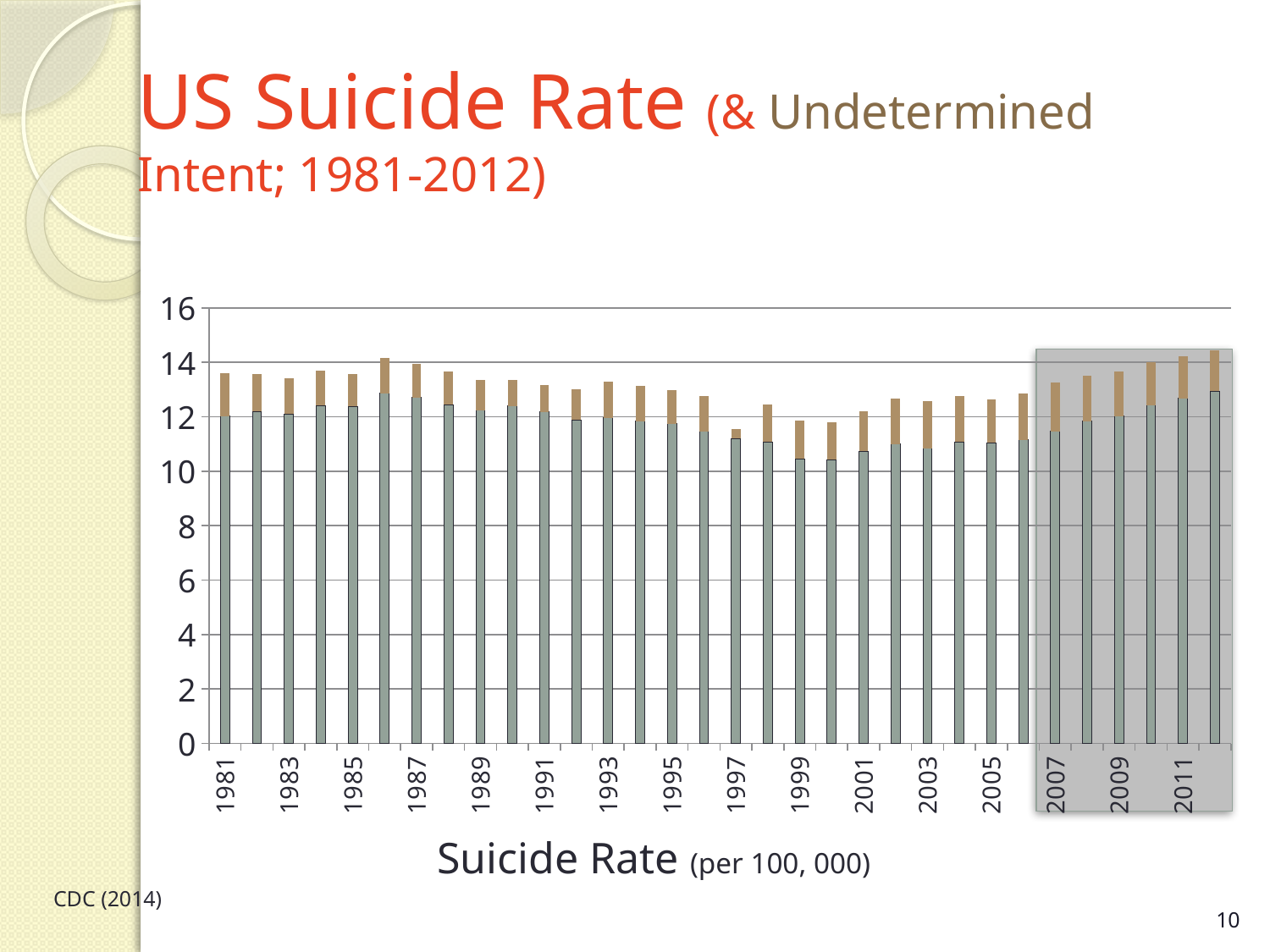
Is the total height of the bar for 1981 greater or less than 12? greater Is the gray (lower) segment of the bar for 2000 greater or less than 12? less Which year has the taller total bar, 1997 or 2012? 2012 What label appears below the x axis of the chart? Suicide Rate (per 100, 000) Which year has the taller total bar, 1981 or 2000? 1981 Is the total height of the bar for 1997 greater or less than 12? less What kind of chart is shown on the slide? bar chart How many years (bars) are plotted in the chart? 32 What is the highest value shown on the y axis? 16 What is the title of the chart on the slide? US Suicide Rate (& Undetermined Intent; 1981-2012) Do the bar heights generally rise or fall from 2000 to 2012? rise